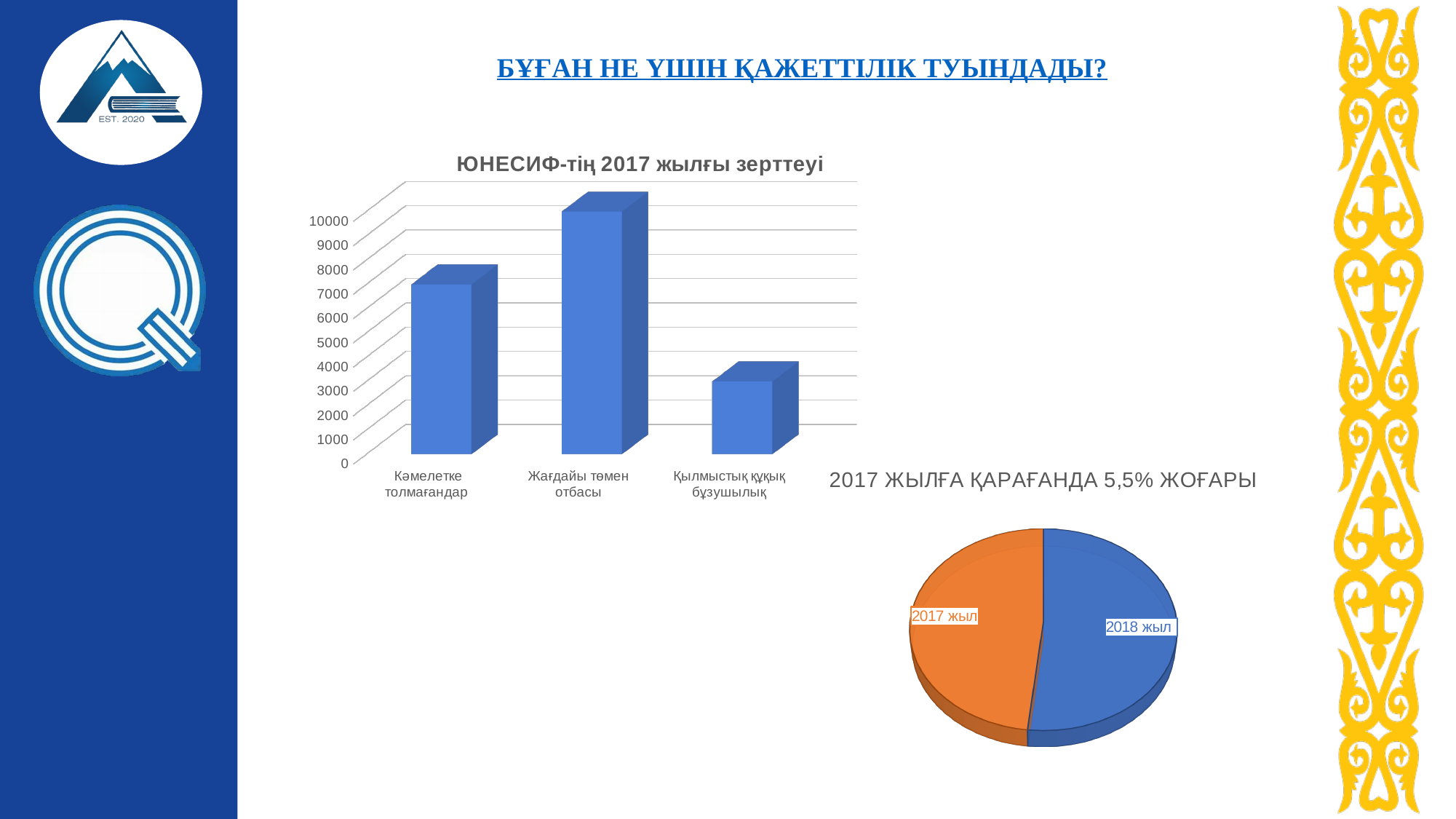
In the chart titled "ЮНЕСИФ-тің 2017 жылғы зерттеуі", which category has the lowest value? Қылмыстық құқық бұзушылық What is the title of the bar chart on the slide? ЮНЕСИФ-тің 2017 жылғы зерттеуі How many slices does the pie chart in the lower right of the slide have? 2 In the chart titled "ЮНЕСИФ-тің 2017 жылғы зерттеуі", is the value for Қылмыстық құқық бұзушылық greater or less than 5000? less In the chart titled "ЮНЕСИФ-тің 2017 жылғы зерттеуі", is the value for Кәмелетке толмағандар greater or less than 5000? greater What kind of chart is the chart titled "ЮНЕСИФ-тің 2017 жылғы зерттеуі"? bar chart How many categories are shown in the chart titled "ЮНЕСИФ-тің 2017 жылғы зерттеуі"? 3 What kind of chart is the chart in the lower right of the slide? pie chart In the chart titled "ЮНЕСИФ-тің 2017 жылғы зерттеуі", is the value for Жағдайы төмен отбасы greater or less than 9000? greater In the chart titled "ЮНЕСИФ-тің 2017 жылғы зерттеуі", which is larger: Кәмелетке толмағандар or Қылмыстық құқық бұзушылық? Кәмелетке толмағандар What are the labels of the two slices in the pie chart in the lower right of the slide? 2017 жыл and 2018 жыл In the chart titled "ЮНЕСИФ-тің 2017 жылғы зерттеуі", which category has the highest value? Жағдайы төмен отбасы